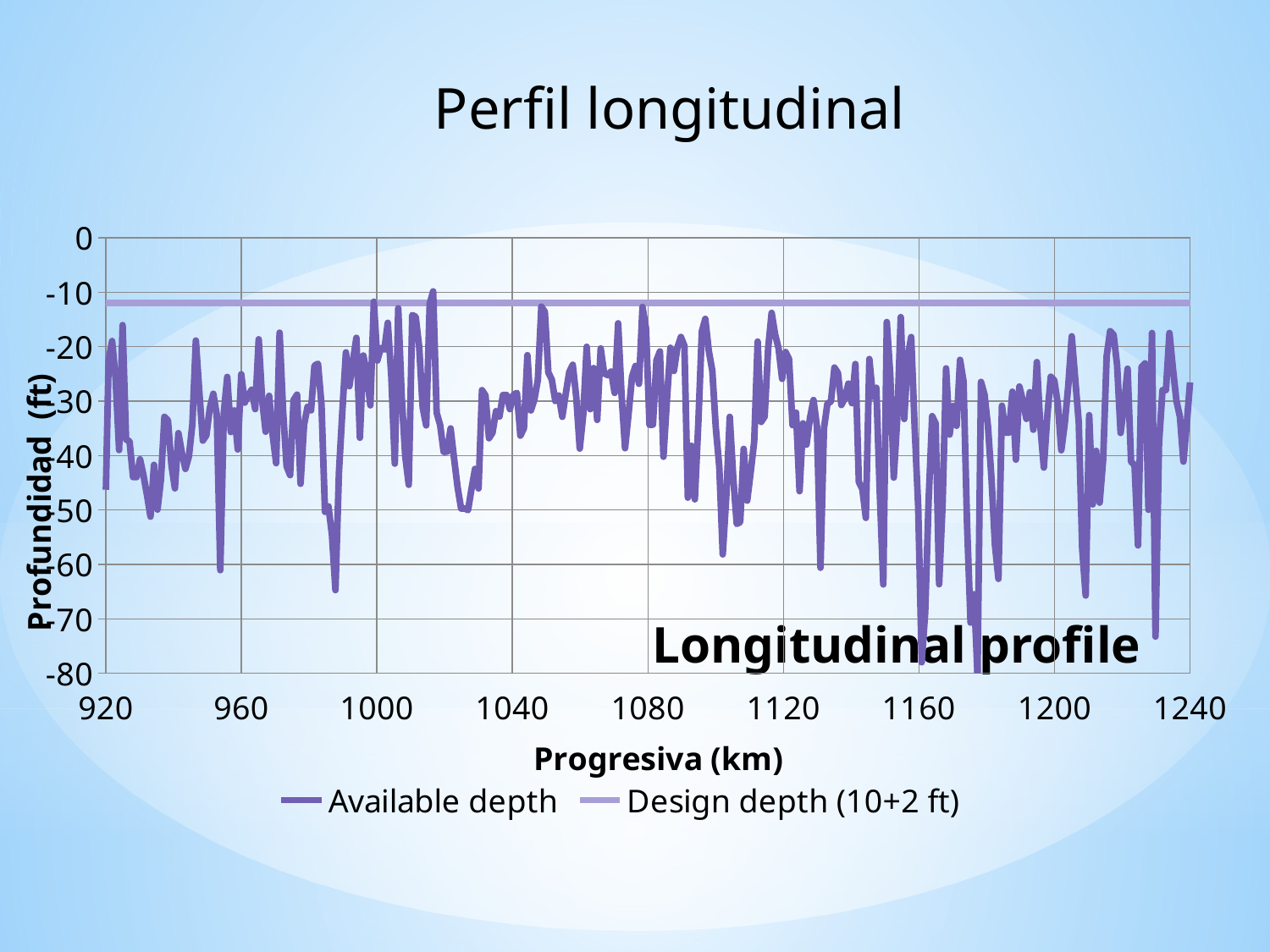
How many series does the legend list? 2 What is the highest value shown on the x axis (Progresiva)? 1240 What is the lowest value shown on the x axis (Progresiva)? 920 Which series is drawn as a flat horizontal line? Design depth (10+2 ft) What is the lowest value shown on the y axis (Profundidad)? -80 What are the two series named in the legend? Available depth; Design depth (10+2 ft) Is the lowest value reached by the Available depth line greater or less than -60? less Is the highest value reached by the Available depth line greater or less than -20? greater What kind of chart is shown on the slide? line chart Is the Design depth (10+2 ft) line greater or less than -10 on the y axis? less